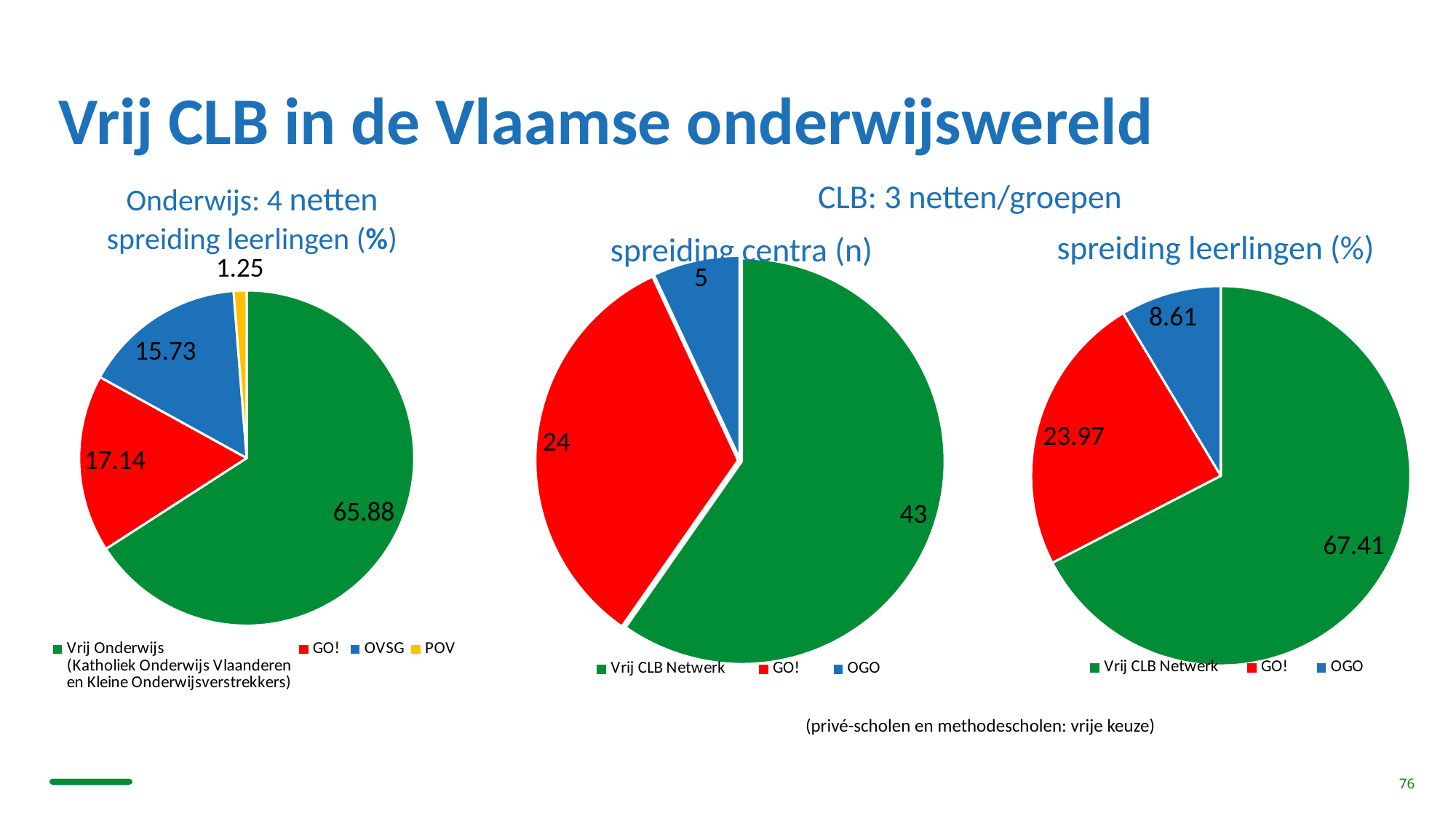
In the middle pie chart (spreiding centra (n)), which category has the largest slice? Vrij CLB Netwerk In the right pie chart (CLB: spreiding leerlingen (%)), which is larger, GO! or OGO? GO! In the right pie chart (CLB: spreiding leerlingen (%)), what is the value for OGO? 8.61 In the middle pie chart (spreiding centra (n)), what is the difference between the Vrij CLB Netwerk value and the GO! value? 19 In the middle pie chart (spreiding centra (n)), what is the total of all slices? 72 What type of chart is the middle chart titled 'spreiding centra (n)'? Pie chart In the middle pie chart (spreiding centra (n)), what is the value for GO!? 24 In the right pie chart (CLB: spreiding leerlingen (%)), how many entries does the legend list? 3 In the left pie chart (Onderwijs: spreiding leerlingen), how many slices does the pie have? 4 In the left pie chart (Onderwijs: spreiding leerlingen), what is the value for Vrij Onderwijs? 65.88 In the left pie chart (Onderwijs: spreiding leerlingen), what is the value for OVSG? 15.73 In the left pie chart (Onderwijs: spreiding leerlingen), which category has the smallest slice? POV